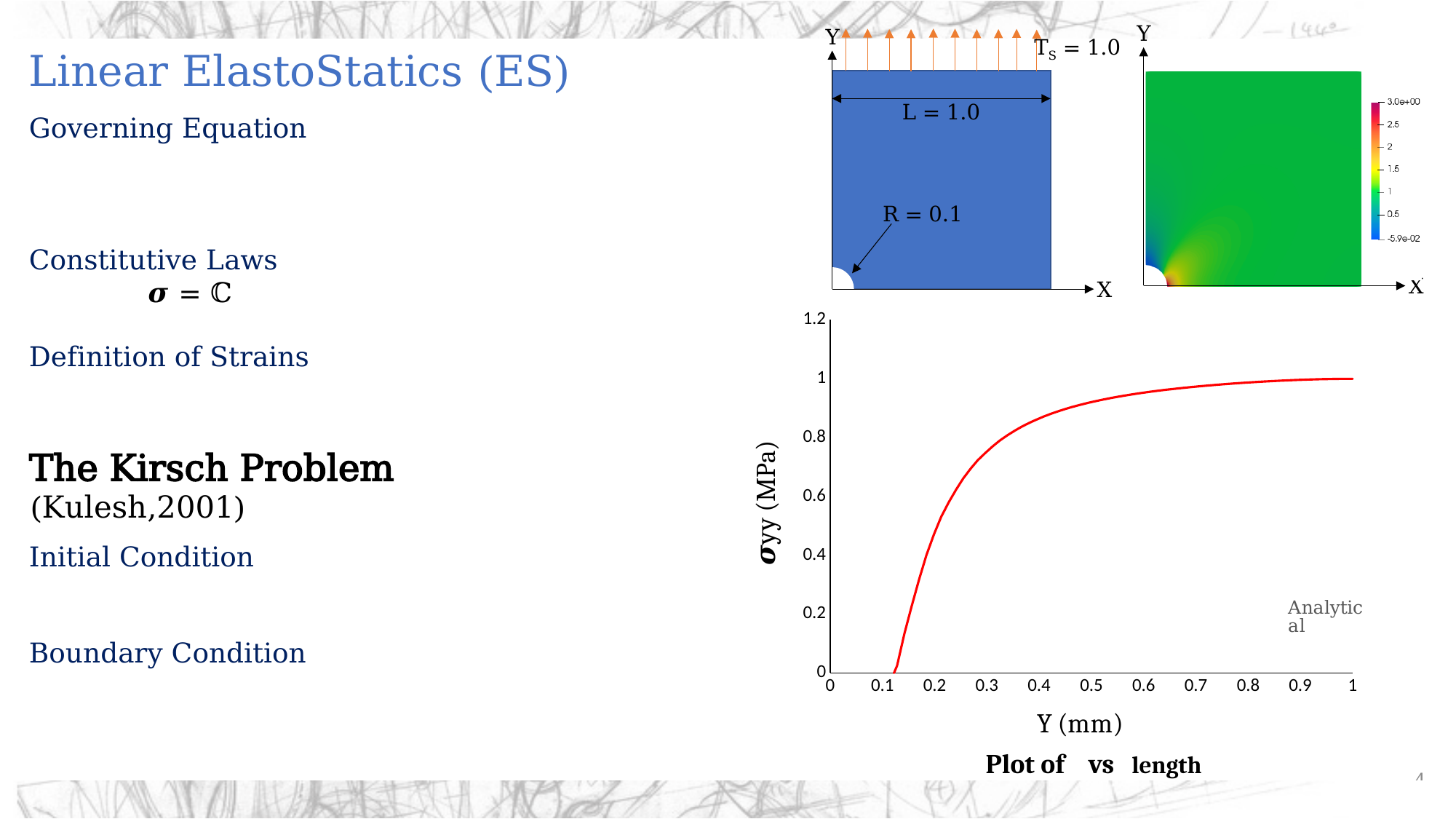
In the σyy vs Y chart, is the value at Y = 1 greater or less than 1.2? less In the σyy vs Y chart, is the value at Y = 0.8 greater or less than 0.8? greater What is the legend entry in the σyy vs Y chart? Analytical What is the label of the vertical axis in the line chart? σyy (MPa) In the σyy vs Y chart, which is larger: the value at Y = 0.2 or the value at Y = 0.6? Y = 0.6 In the σyy vs Y chart, is the value at Y = 0.15 greater or less than 0.4? less What is the highest tick label shown on the vertical axis of the σyy vs Y chart? 1.2 How many series does the legend of the σyy vs Y chart list? 1 What kind of chart is shown at the bottom right of the slide? line chart In the σyy vs Y chart, does the value rise or fall as Y increases from 0.1 to 1? rise